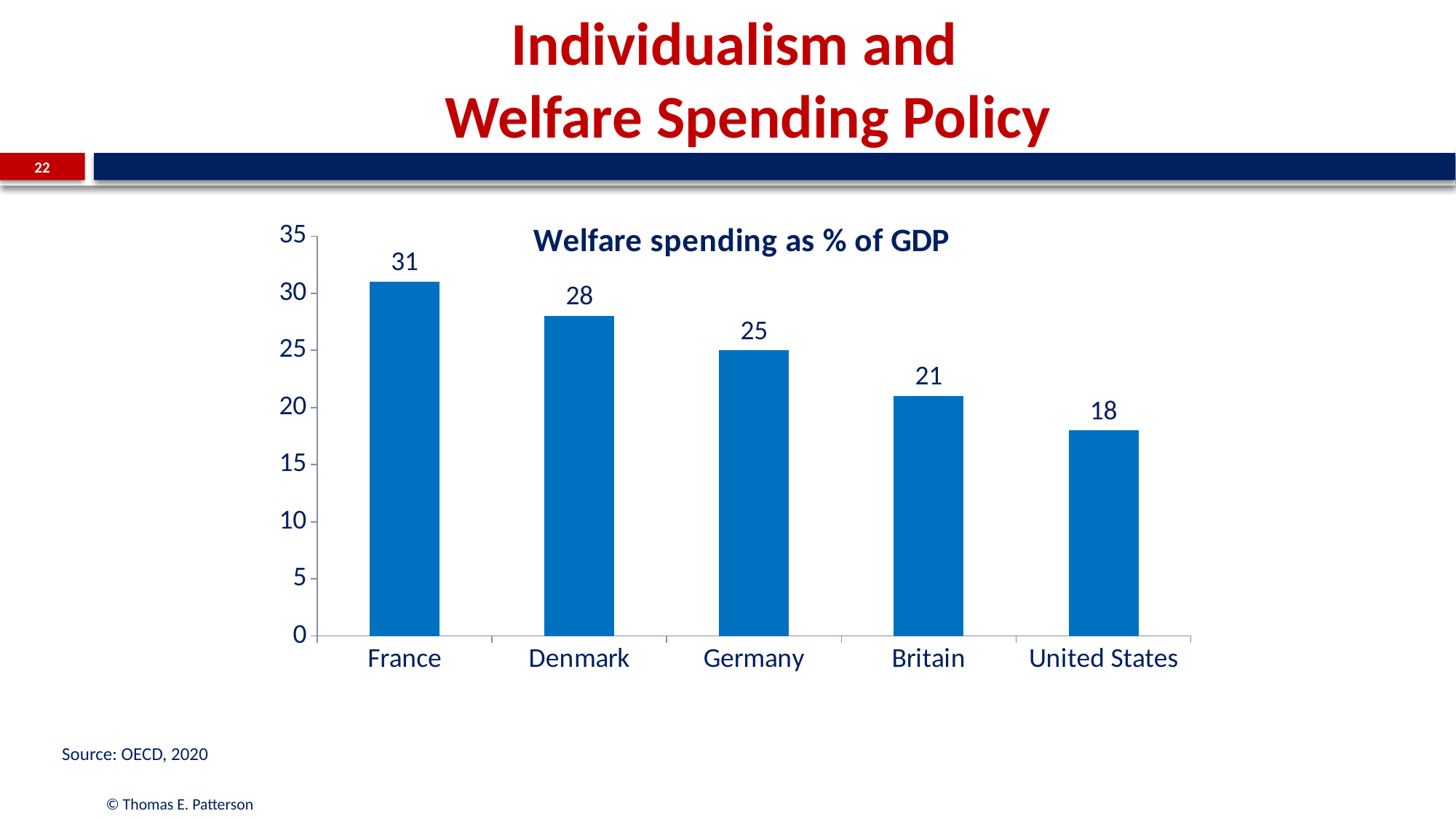
What is the welfare spending as % of GDP for France? 31 What is the difference between the welfare spending values for France and the United States? 13 What kind of chart is shown on the slide? Bar chart What is the welfare spending as % of GDP for Germany? 25 Which has a higher welfare spending as % of GDP, Denmark or Germany? Denmark What is the difference between the welfare spending values for Denmark and Britain? 7 What is the welfare spending as % of GDP for the United States? 18 How many countries are shown in the chart? 5 Which country has the highest welfare spending as % of GDP? France Which country has the lowest welfare spending as % of GDP? United States Do the values rise or fall from left to right across the countries? Fall Is the value for Britain greater or less than 25? less